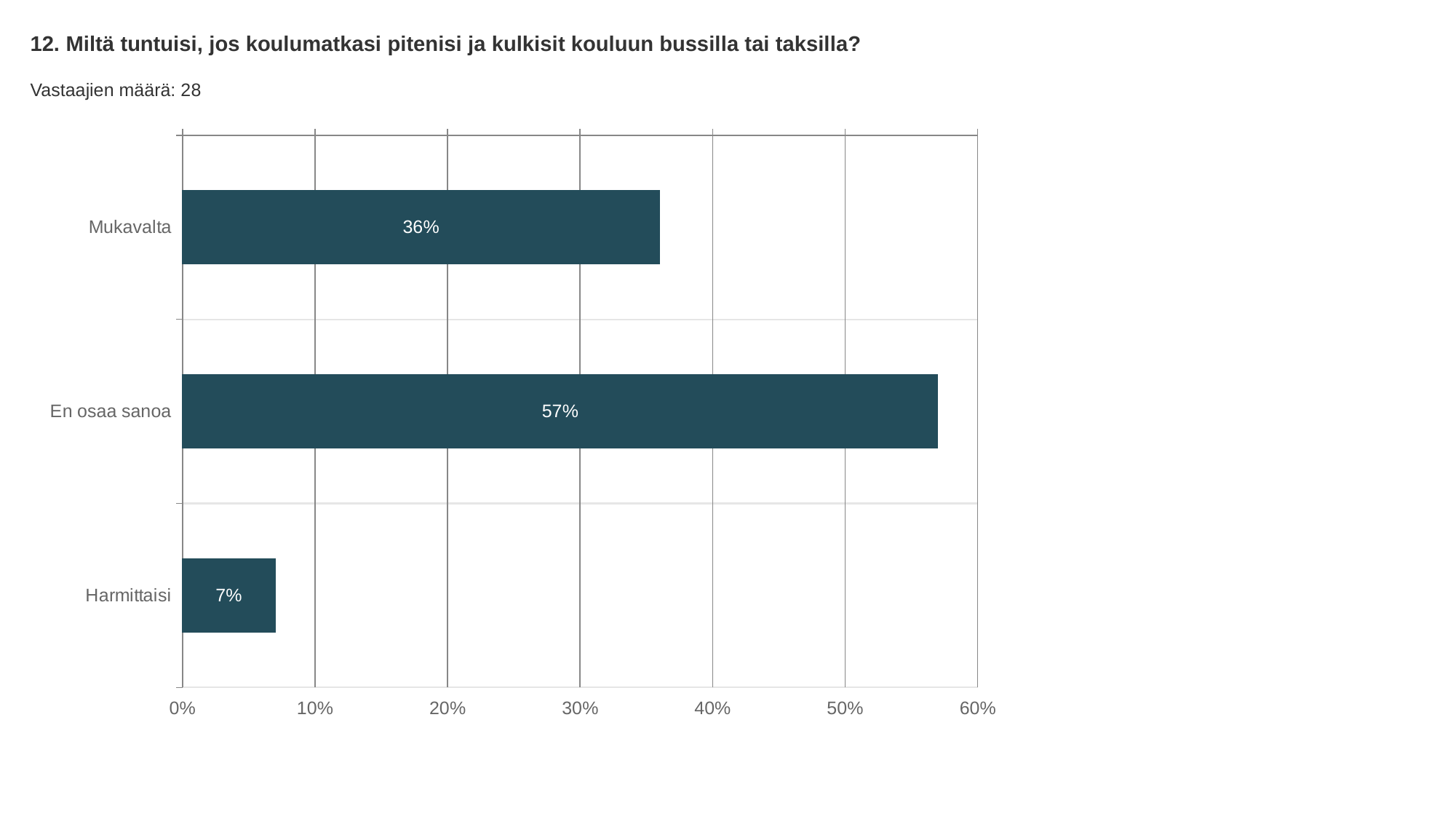
How many respondents (Vastaajien määrä) does the slide report? 28 What kind of chart is shown on the slide? bar chart How many categories are shown in the chart? 3 Which category has the highest value? En osaa sanoa What is the value for Harmittaisi? 7% What is the difference between the values for En osaa sanoa and Mukavalta? 21% What is the value for Mukavalta? 36% Which is larger, the value for Mukavalta or the value for Harmittaisi? Mukavalta Is the value for En osaa sanoa greater or less than 50%? greater What is the difference between the values for Mukavalta and Harmittaisi? 29% What is the value for En osaa sanoa? 57% Which category has the lowest value? Harmittaisi